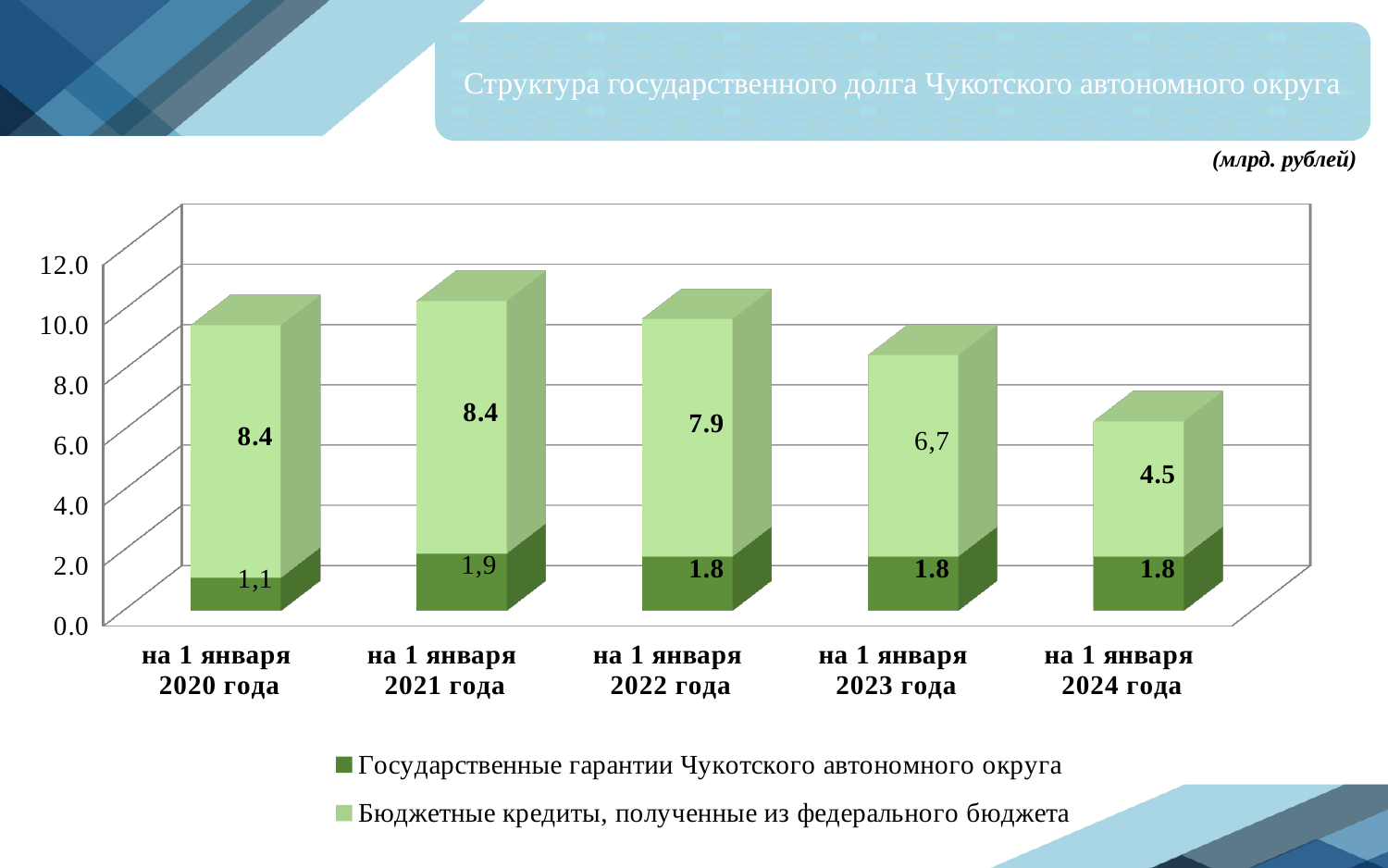
What is the value of budget credits on 1 January 2024? 4.5 On which date is the value of budget credits the lowest? на 1 января 2024 года Do the budget credit values rise or fall from 1 January 2021 to 1 January 2024? fall What is the value of budget credits received from the federal budget (Бюджетные кредиты) on 1 January 2022? 7.9 On which date is the value of state guarantees the lowest? на 1 января 2020 года What is the total of the stacked bar for 1 January 2022? 9.7 What is the value of state guarantees (Государственные гарантии) on 1 January 2021? 1,9 How many dates (categories) are shown on the x axis? 5 What kind of chart is shown on the slide? bar chart Which is larger: budget credits on 1 January 2023 or on 1 January 2024? на 1 января 2023 года What is the difference between budget credits on 1 January 2021 and on 1 January 2024? 3.9 How many series does the legend list? 2